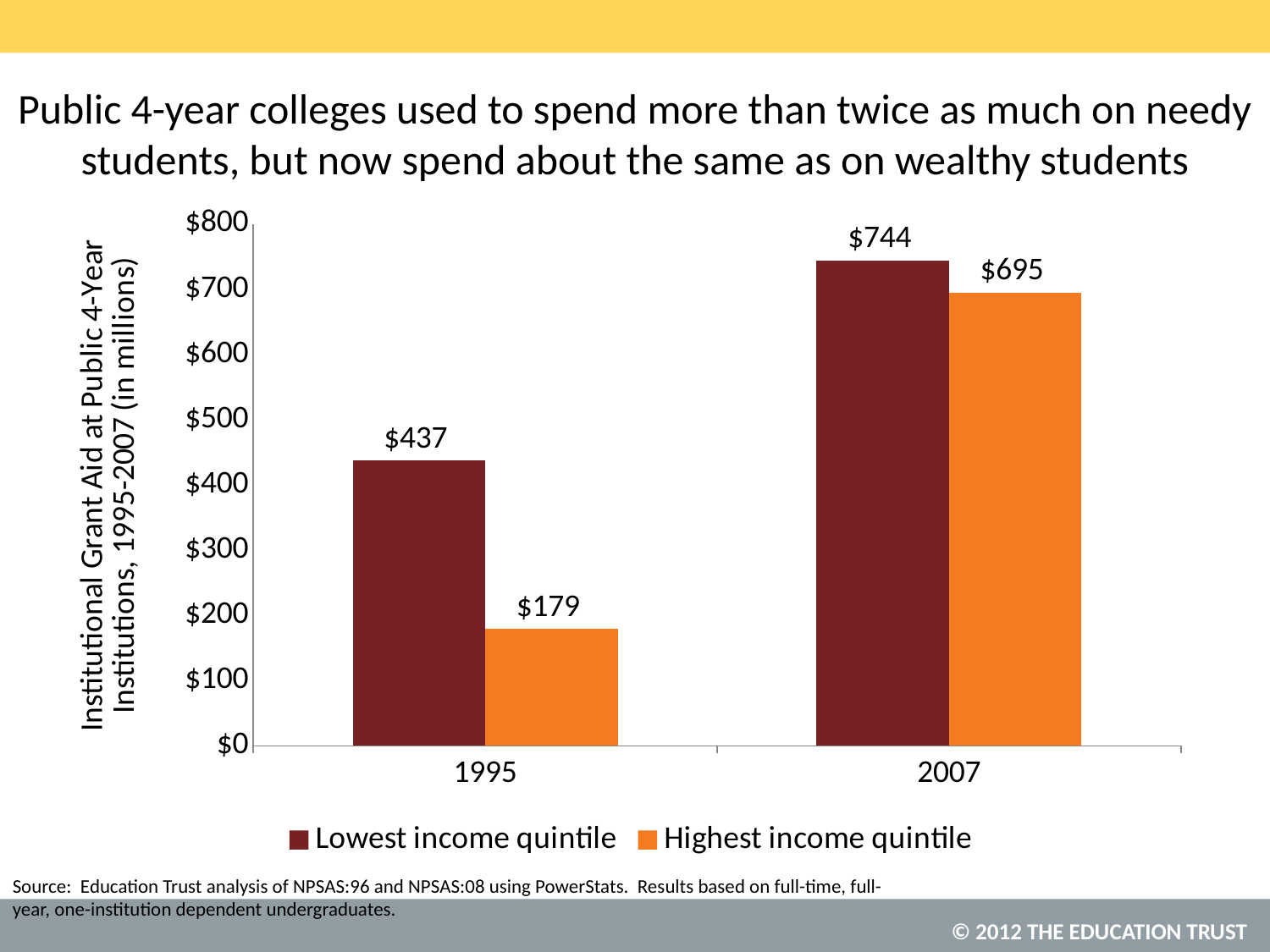
What is the difference between the lowest and highest income quintile values in 2007? $49 How many years are shown on the x axis? 2 Which year and series has the highest value on the chart? Lowest income quintile, 2007 How many series does the legend list? 2 In 2007, which is larger: the lowest income quintile or the highest income quintile? Lowest income quintile What kind of chart is shown on the slide? Bar chart Which bar shows the lowest value on the chart? Highest income quintile, 1995 What was the institutional grant aid for the highest income quintile in 2007? $695 What is the difference between the lowest and highest income quintile values in 1995? $258 Does the highest income quintile value rise or fall from 1995 to 2007? Rise What was the institutional grant aid for the highest income quintile in 1995? $179 What was the institutional grant aid for the lowest income quintile in 1995? $437